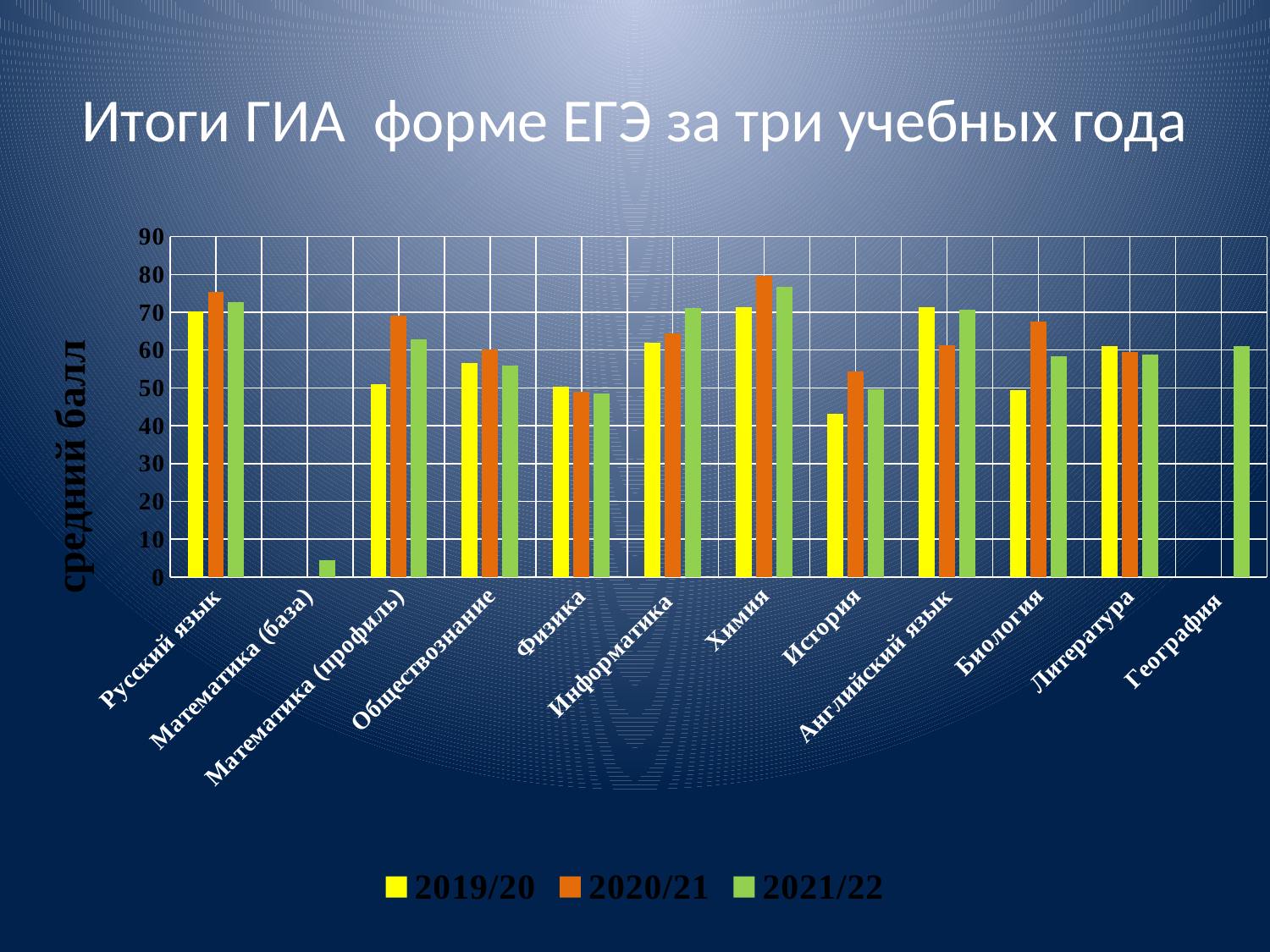
Is the 2019/20 value for История greater or less than 50? less How many series does the legend list? 3 For Русский язык, which series has the larger value: 2019/20 or 2020/21? 2020/21 Do the values for Информатика rise or fall from 2019/20 to 2021/22? rise Which subject has the lowest value for the 2021/22 series? Математика (база) For Биология, which series has the larger value: 2020/21 or 2021/22? 2020/21 Is the 2021/22 value for Математика (база) greater or less than 10? less What is the title of the vertical axis? средний балл What kind of chart is shown on the slide? bar chart Which subject has the highest value for the 2020/21 series? Химия Is the 2020/21 value for Химия greater or less than 70? greater How many subject categories are shown on the x axis? 12